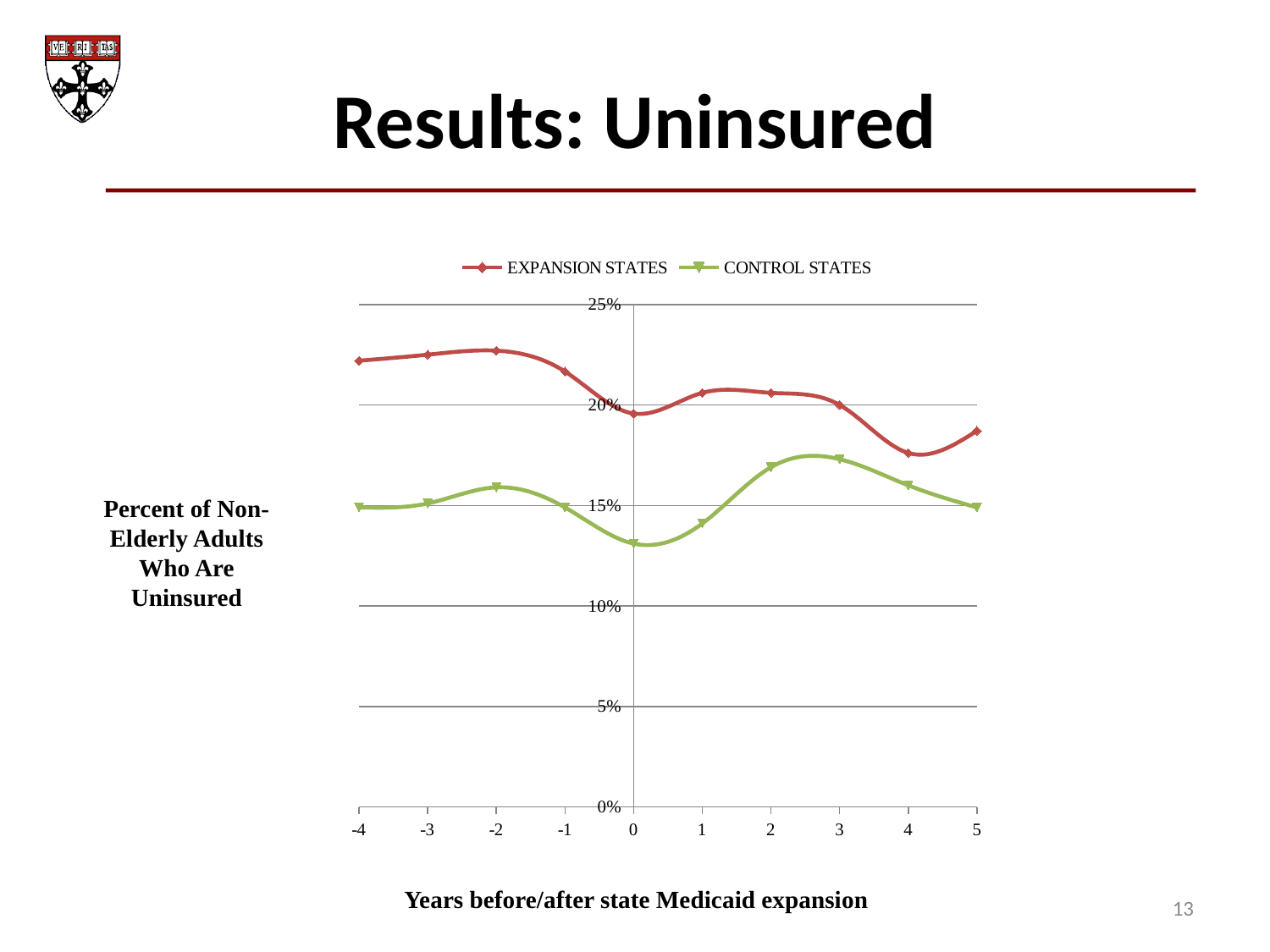
What kind of chart is shown on the slide? line chart Is the value for CONTROL STATES at year 0 greater or less than 15%? less At which year is the value for CONTROL STATES lowest? 0 Is the value for EXPANSION STATES at year -4 greater or less than 20%? greater At which year is the value for EXPANSION STATES lowest? 4 How many points along the x axis (years) are plotted for each series? 10 Is the value for CONTROL STATES at year 2 greater or less than 15%? greater At year 0, which series has the larger value, EXPANSION STATES or CONTROL STATES? EXPANSION STATES What is the x-axis title of the chart? Years before/after state Medicaid expansion How many series does the legend list? 2 Does the value for CONTROL STATES rise or fall from year 0 to year 2? rise